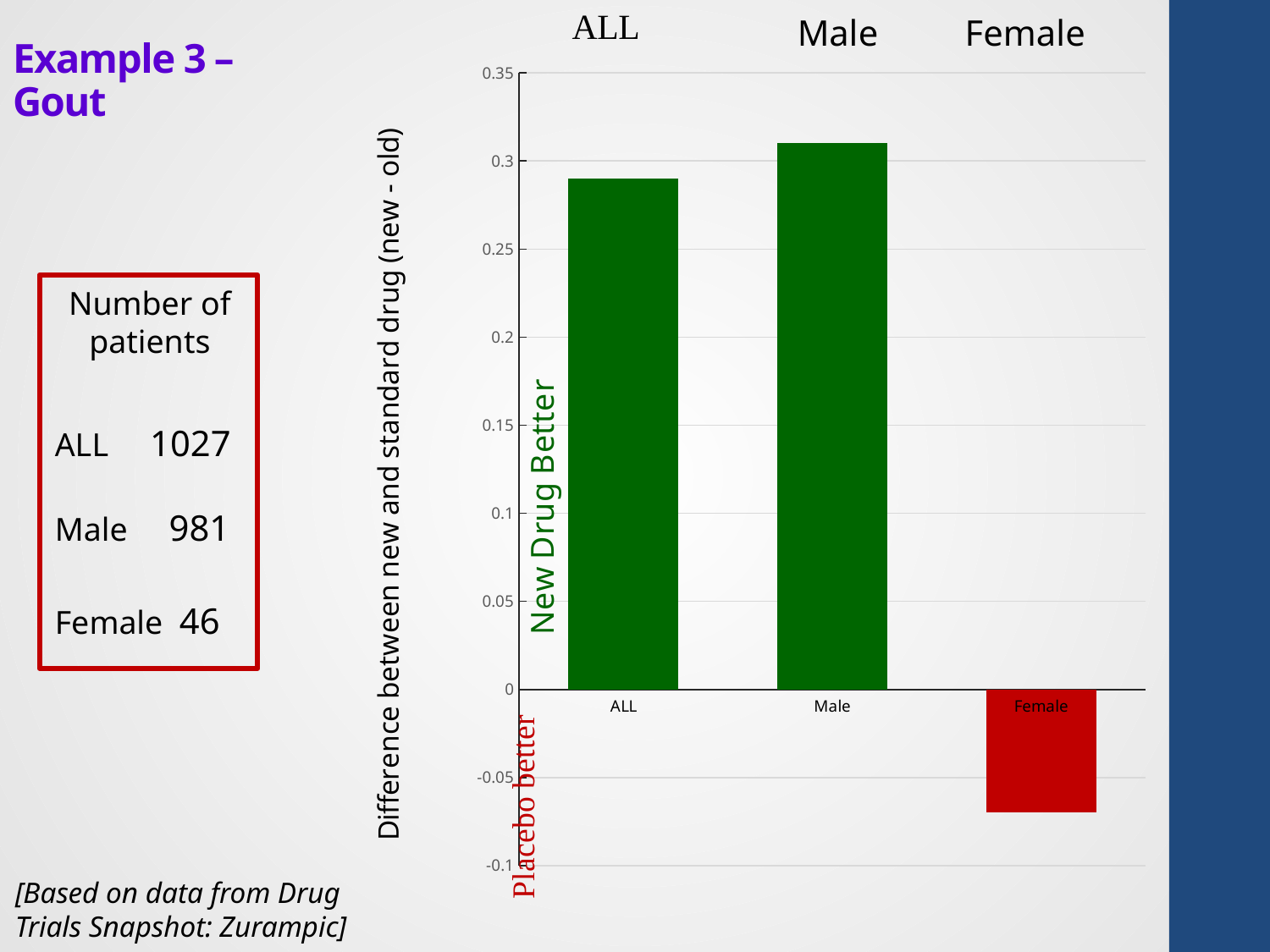
Which is larger, the value for ALL or the value for Female? ALL Is the value for ALL greater or less than 0.3? less Which category has the highest value on the chart? Male What colour is the bar for Female? red What is the label on the vertical axis of the chart? Difference between new and standard drug (new - old) Which is larger, the value for Male or the value for ALL? Male Is the value for ALL greater or less than 0.25? greater Is the value for Female greater or less than -0.05? less How many categories are plotted on the chart? 3 What kind of chart is shown on the slide? bar chart Which category has the lowest value on the chart? Female